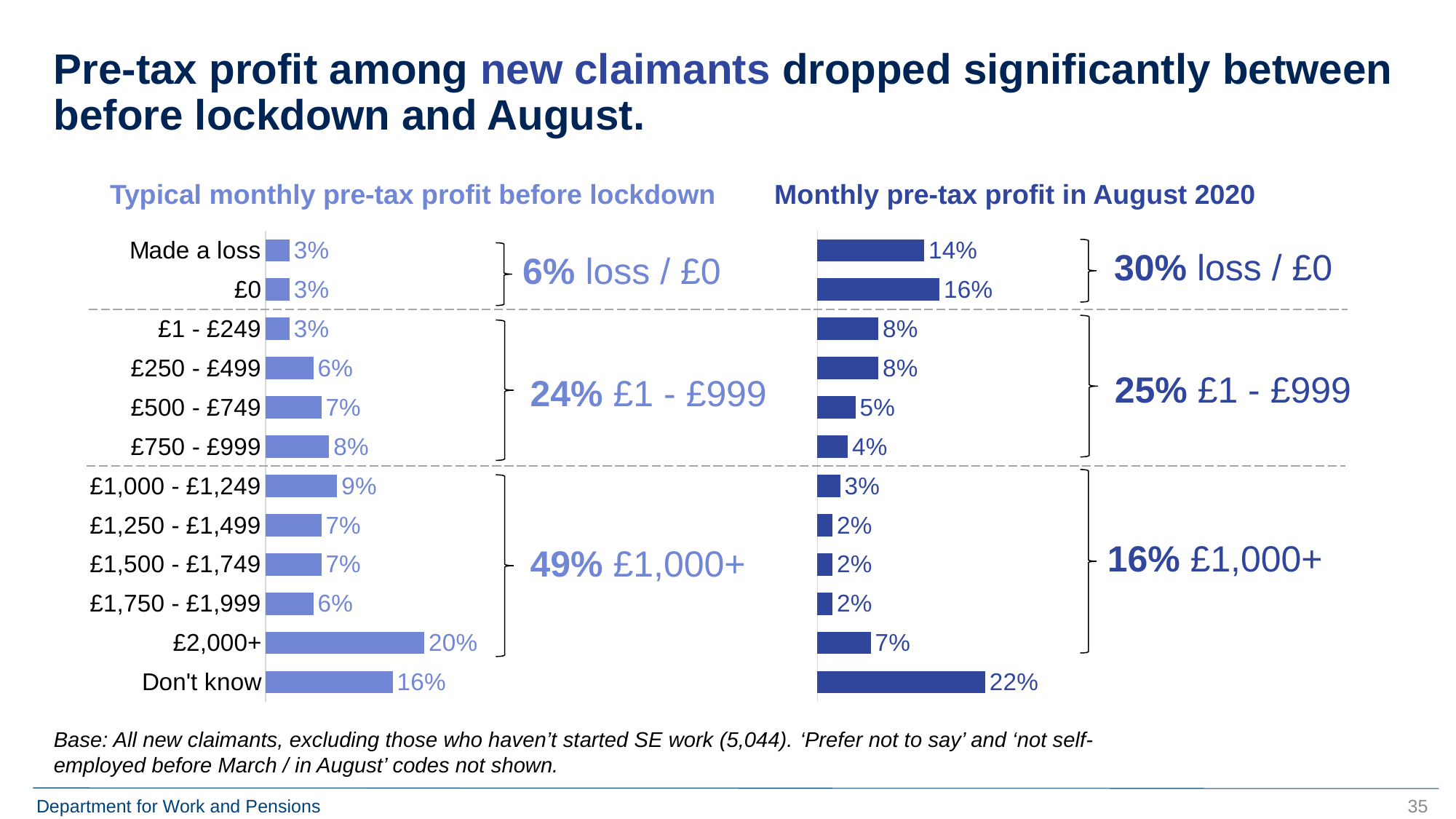
In the 'Monthly pre-tax profit in August 2020' chart, what is the difference between the values for Don't know and £2,000+? 15% In the 'Typical monthly pre-tax profit before lockdown' chart, which category has the highest value? £2,000+ In the 'Monthly pre-tax profit in August 2020' chart, which category has the highest value? Don't know In the 'Typical monthly pre-tax profit before lockdown' chart, what is the value for £2,000+? 20% Which is larger: the value for Made a loss in the 'Typical monthly pre-tax profit before lockdown' chart or in the 'Monthly pre-tax profit in August 2020' chart? Monthly pre-tax profit in August 2020 How many categories are shown in the 'Monthly pre-tax profit in August 2020' chart? 12 In the 'Monthly pre-tax profit in August 2020' chart, what combined share is shown for the £1,000+ group? 16% What type of chart is the 'Typical monthly pre-tax profit before lockdown' chart? Bar chart In the 'Monthly pre-tax profit in August 2020' chart, what is the value for Made a loss? 14% In the 'Typical monthly pre-tax profit before lockdown' chart, what is the value for £1,000 - £1,249? 9% In the 'Monthly pre-tax profit in August 2020' chart, what is the value for £0? 16% In the 'Typical monthly pre-tax profit before lockdown' chart, what is the difference between the values for £2,000+ and Don't know? 4%